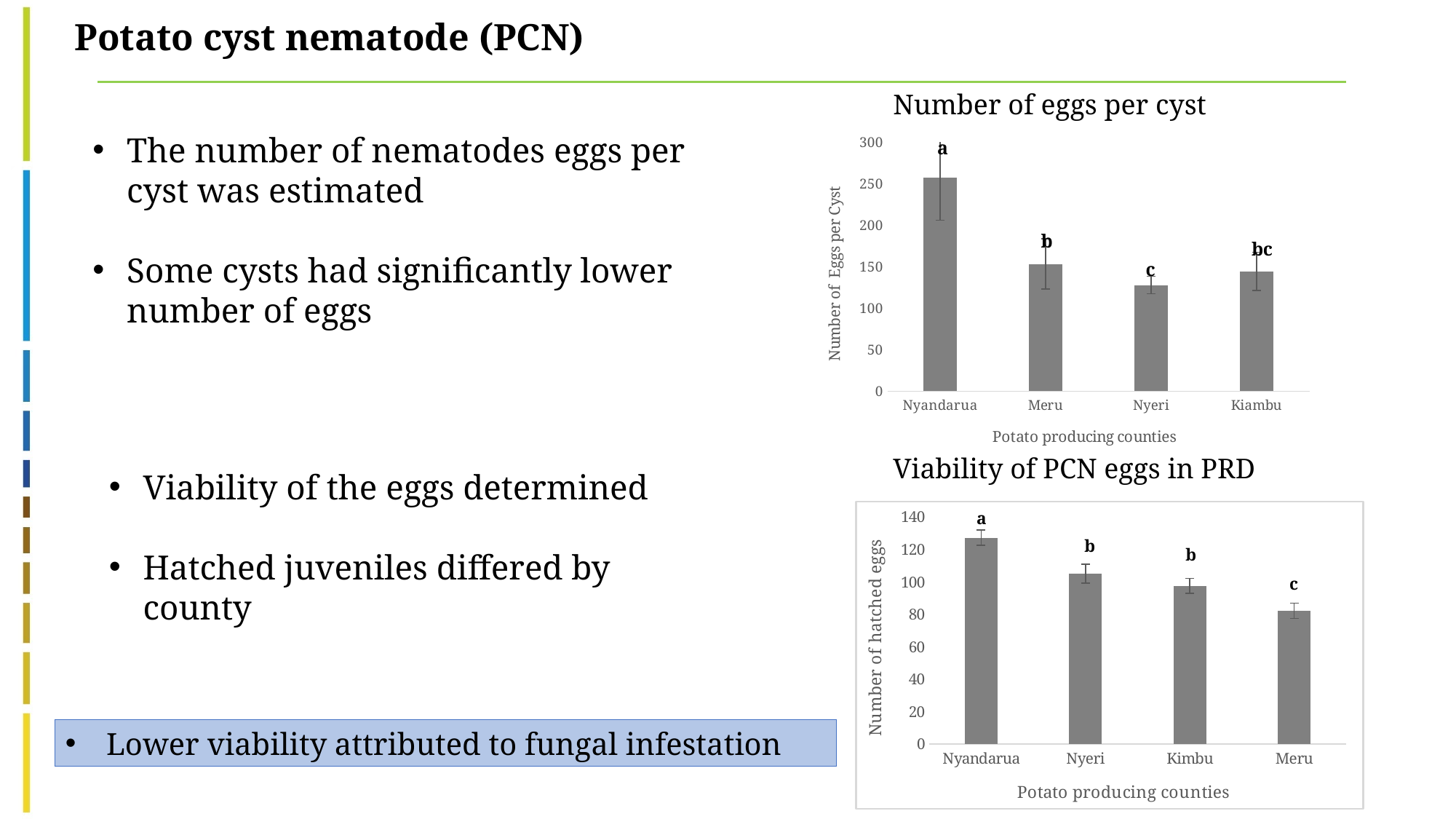
In the 'Number of eggs per cyst' chart, is the value for Nyandarua greater or less than 200? greater In the 'Number of eggs per cyst' chart, which is larger, the value for Nyandarua or the value for Meru? Nyandarua How many counties are shown in the 'Number of eggs per cyst' chart? 4 In the 'Number of eggs per cyst' chart, which county has the lowest number of eggs per cyst? Nyeri In the 'Viability of PCN eggs in PRD' chart, is the value for Meru greater or less than 100? less In the 'Viability of PCN eggs in PRD' chart, which county has the highest number of hatched eggs? Nyandarua In the 'Number of eggs per cyst' chart, which county has the highest number of eggs per cyst? Nyandarua In the 'Viability of PCN eggs in PRD' chart, which county has the lowest number of hatched eggs? Meru What is the y-axis title of the 'Viability of PCN eggs in PRD' chart? Number of hatched eggs What kind of chart is the 'Number of eggs per cyst' chart? bar chart In the 'Number of eggs per cyst' chart, is the value for Nyeri greater or less than 150? less